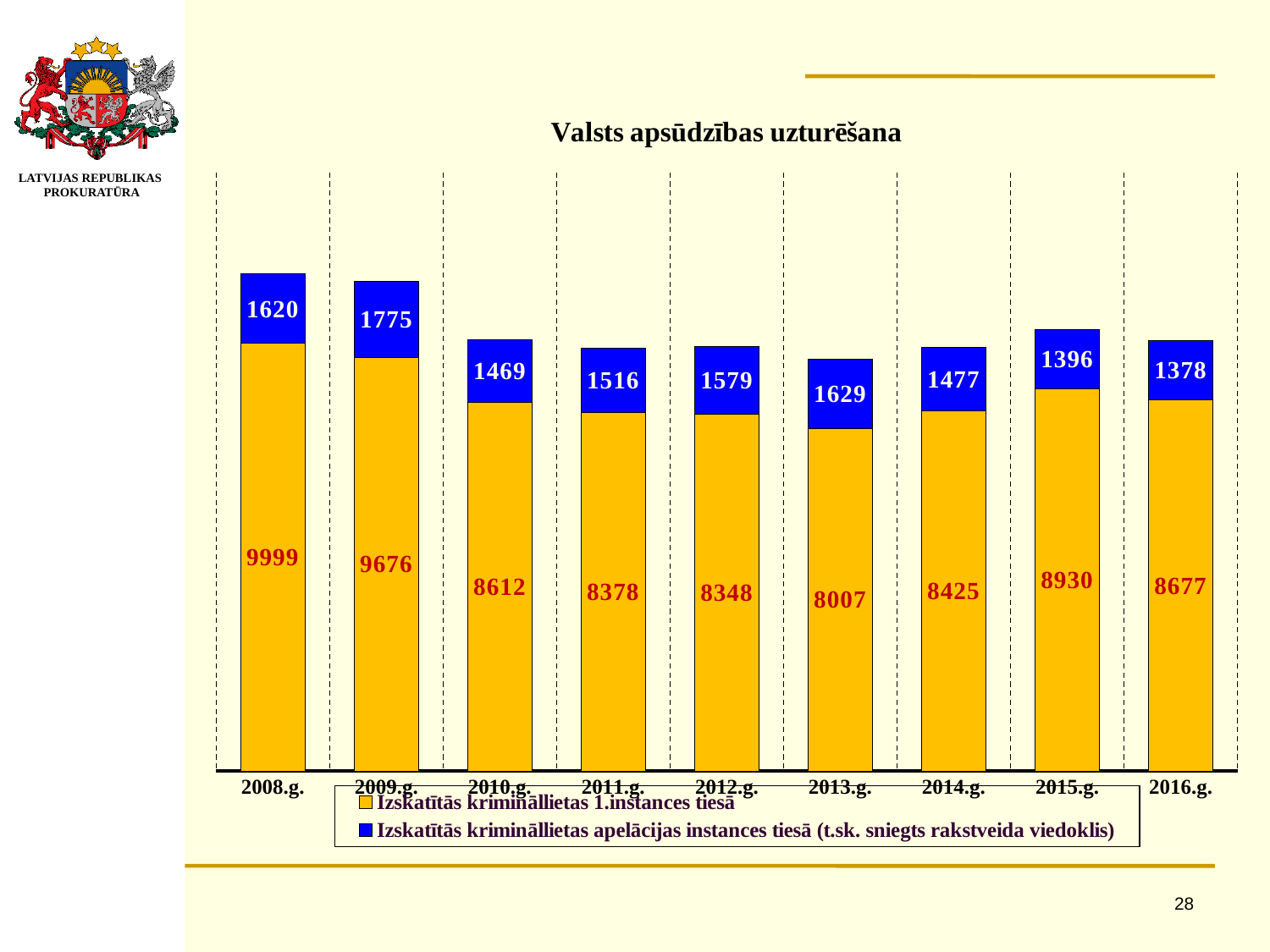
How many years are shown on the x axis? 9 Which year has the lowest value for 'Izskatītās krimināllietas 1.instances tiesā'? 2013.g. Which year has the lowest value for 'Izskatītās krimināllietas apelācijas instances tiesā'? 2016.g. What is the value for 'Izskatītās krimināllietas 1.instances tiesā' in 2008.g.? 9999 What is the value for 'Izskatītās krimināllietas apelācijas instances tiesā' in 2013.g.? 1629 What is the difference between the 'Izskatītās krimināllietas 1.instances tiesā' values for 2008.g. and 2009.g.? 323 Which year has the highest value for 'Izskatītās krimināllietas 1.instances tiesā'? 2008.g. What is the total of the stacked bar for 2016.g.? 10055 What is the value for 'Izskatītās krimināllietas 1.instances tiesā' in 2015.g.? 8930 What type of chart is shown on the slide? stacked bar chart Which year has the highest value for 'Izskatītās krimināllietas apelācijas instances tiesā'? 2009.g. How many series does the legend list? 2